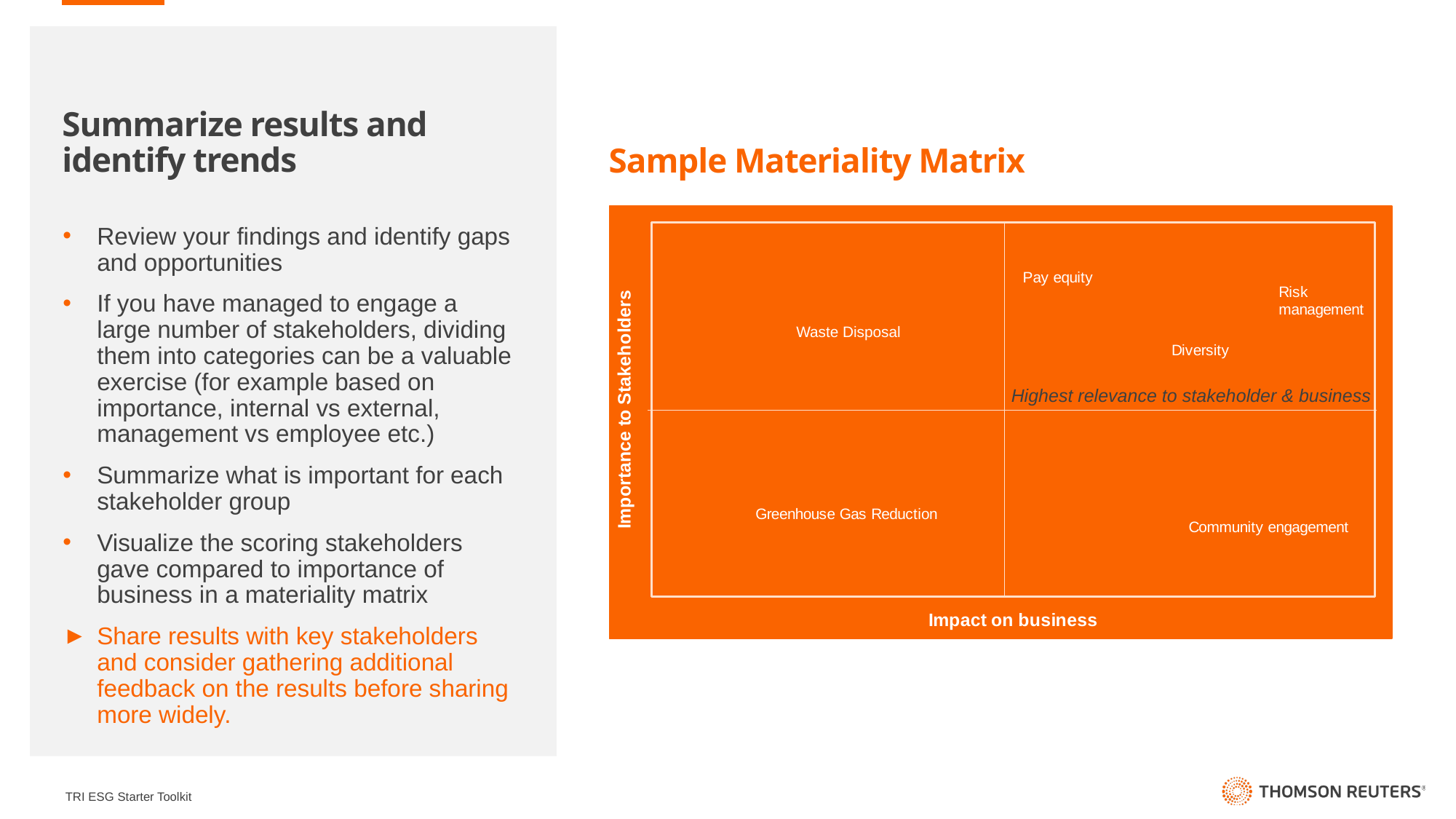
What kind of chart is shown on the slide? A 2x2 materiality matrix (quadrant chart) Which item is plotted furthest right on the Impact on business axis? Risk management What is the label of the vertical axis of the materiality matrix? Importance to Stakeholders How many items are plotted in the materiality matrix? 6 Which quadrant of the matrix is labelled 'Highest relevance to stakeholder & business'? Top-right Which item is plotted highest on the Importance to Stakeholders axis? Pay equity What is the label of the horizontal axis of the materiality matrix? Impact on business In which quadrant of the matrix is Community engagement plotted? Bottom-right What is the title of the chart on the slide? Sample Materiality Matrix Which has a higher Importance to Stakeholders, Waste Disposal or Greenhouse Gas Reduction? Waste Disposal In which quadrant of the matrix is Waste Disposal plotted? Top-left